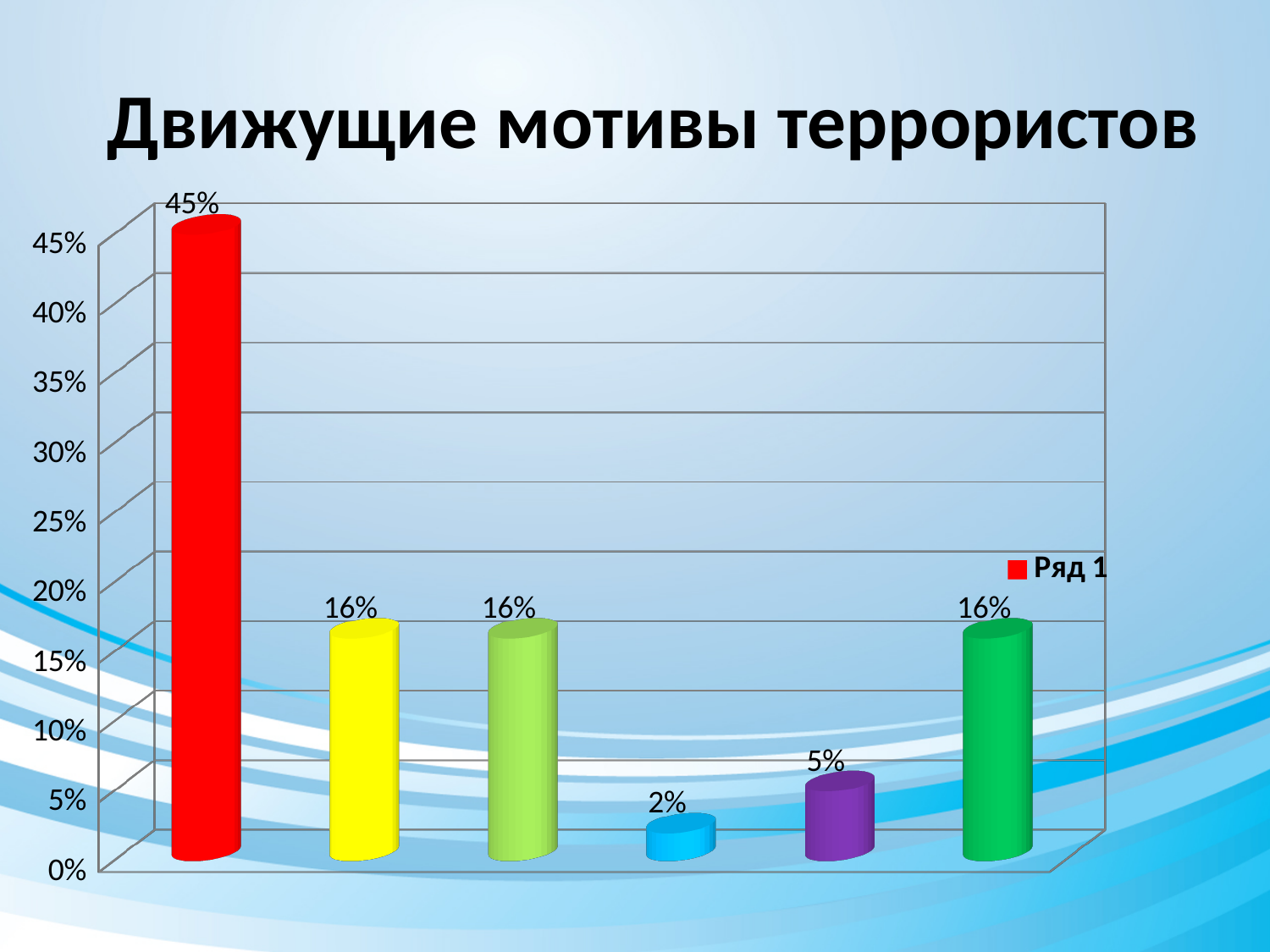
What is the difference between the purple bar and the blue bar? 3% What is the value shown on the blue bar? 2% What is the title of the chart? Движущие мотивы террористов What is the value shown on the purple bar? 5% What is the difference between the red bar and the yellow bar? 29% Which bar has the highest value? The red bar (45%) Which bar has the lowest value? The blue bar (2%) What is the value shown on the yellow bar? 16% How many series does the legend list? 1 What is the value shown on the red bar? 45% How many bars are plotted in the chart? 6 Which is larger, the purple bar or the blue bar? The purple bar